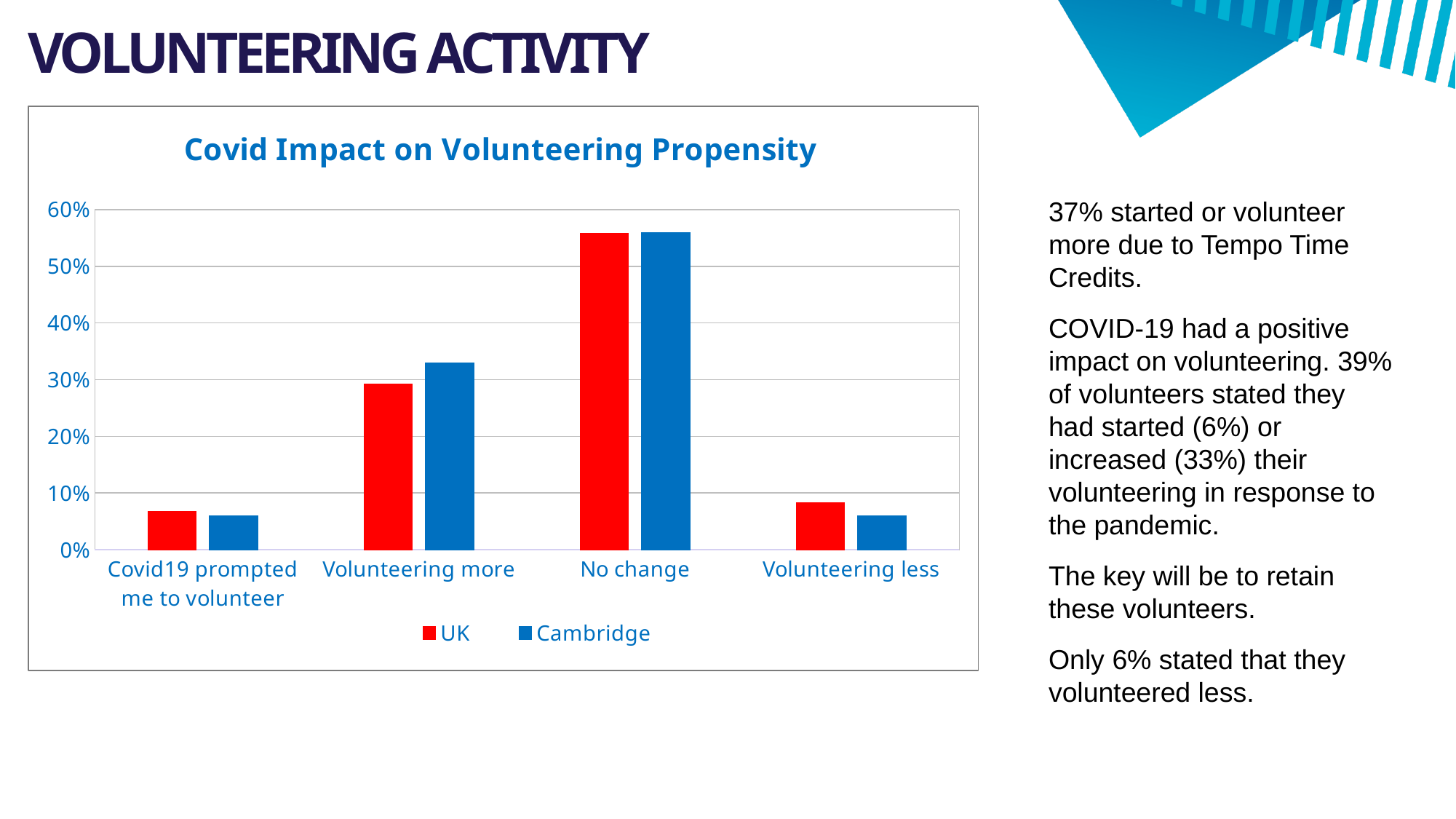
Is the Cambridge value for 'Volunteering more' greater or less than 30%? greater Is the UK value for 'Volunteering less' greater or less than 10%? less For 'Volunteering less', which is larger, the UK value or the Cambridge value? UK For 'Volunteering more', which is larger, the UK value or the Cambridge value? Cambridge What kind of chart is shown on the slide? bar chart Is the UK value for 'No change' greater or less than 50%? greater How many categories are shown on the x axis of the chart? 4 How many series does the chart legend list? 2 Which colour represents the UK series in the chart? red Which category has the highest value for the Cambridge series? No change Which category has the highest value for the UK series? No change What is the title of the chart? Covid Impact on Volunteering Propensity